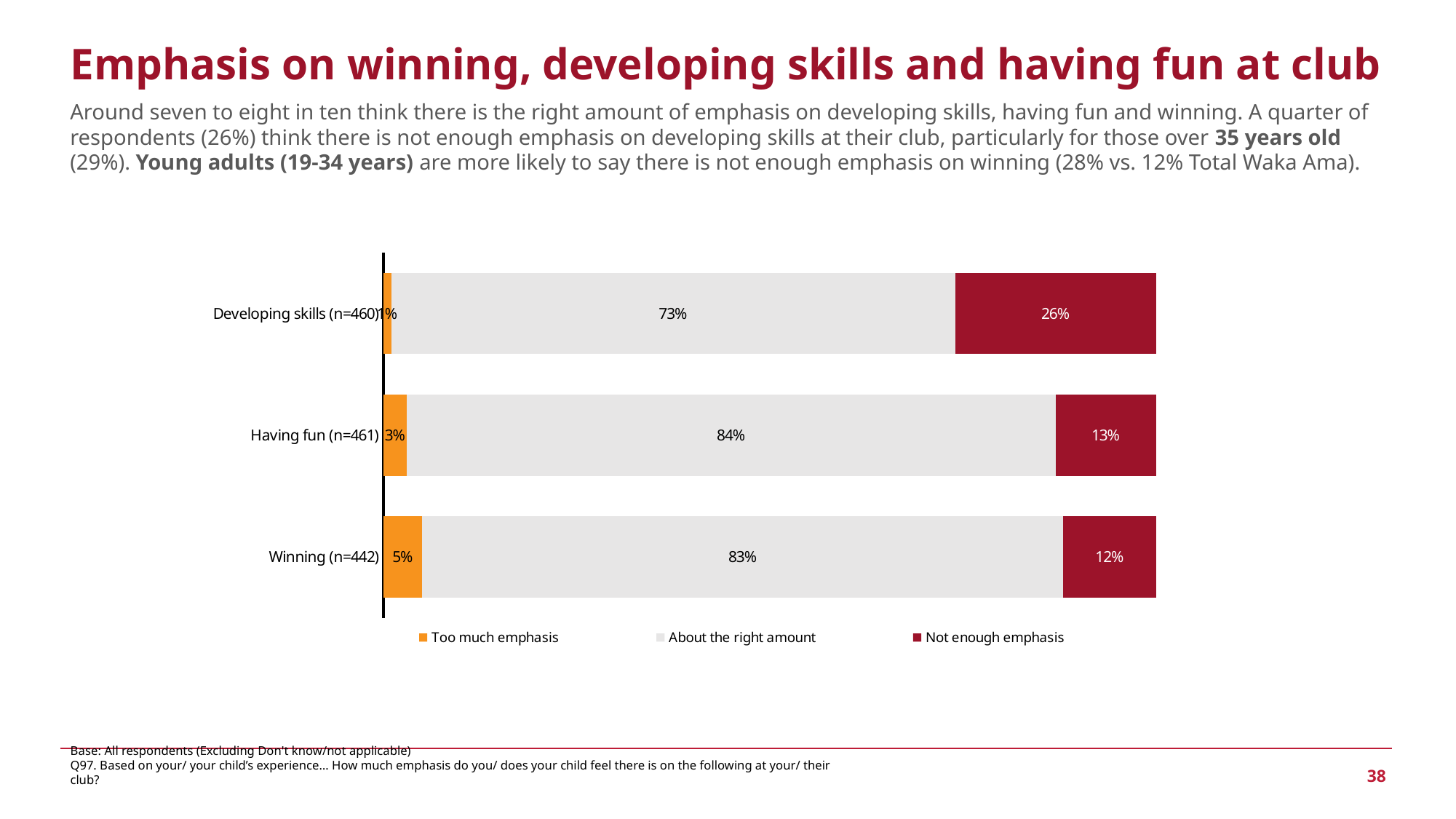
How many categories are shown in the chart? 3 Which colour represents 'Not enough emphasis' in the chart? Dark red What percentage of respondents say there is about the right amount of emphasis on developing skills? 73% What is the total of the three segments in the 'Having fun' bar? 100% How many series does the legend list? 3 What kind of chart is shown on the slide? Stacked bar chart What is the difference between the 'Not enough emphasis' percentages for developing skills and winning? 14 percentage points What percentage of respondents say there is too much emphasis on winning? 5% Which category has the highest share of respondents saying there is not enough emphasis? Developing skills What percentage of respondents say there is not enough emphasis on having fun? 13% Which category has the lowest share of respondents saying there is too much emphasis? Developing skills Which is larger: the 'About the right amount' share for having fun or for winning? Having fun